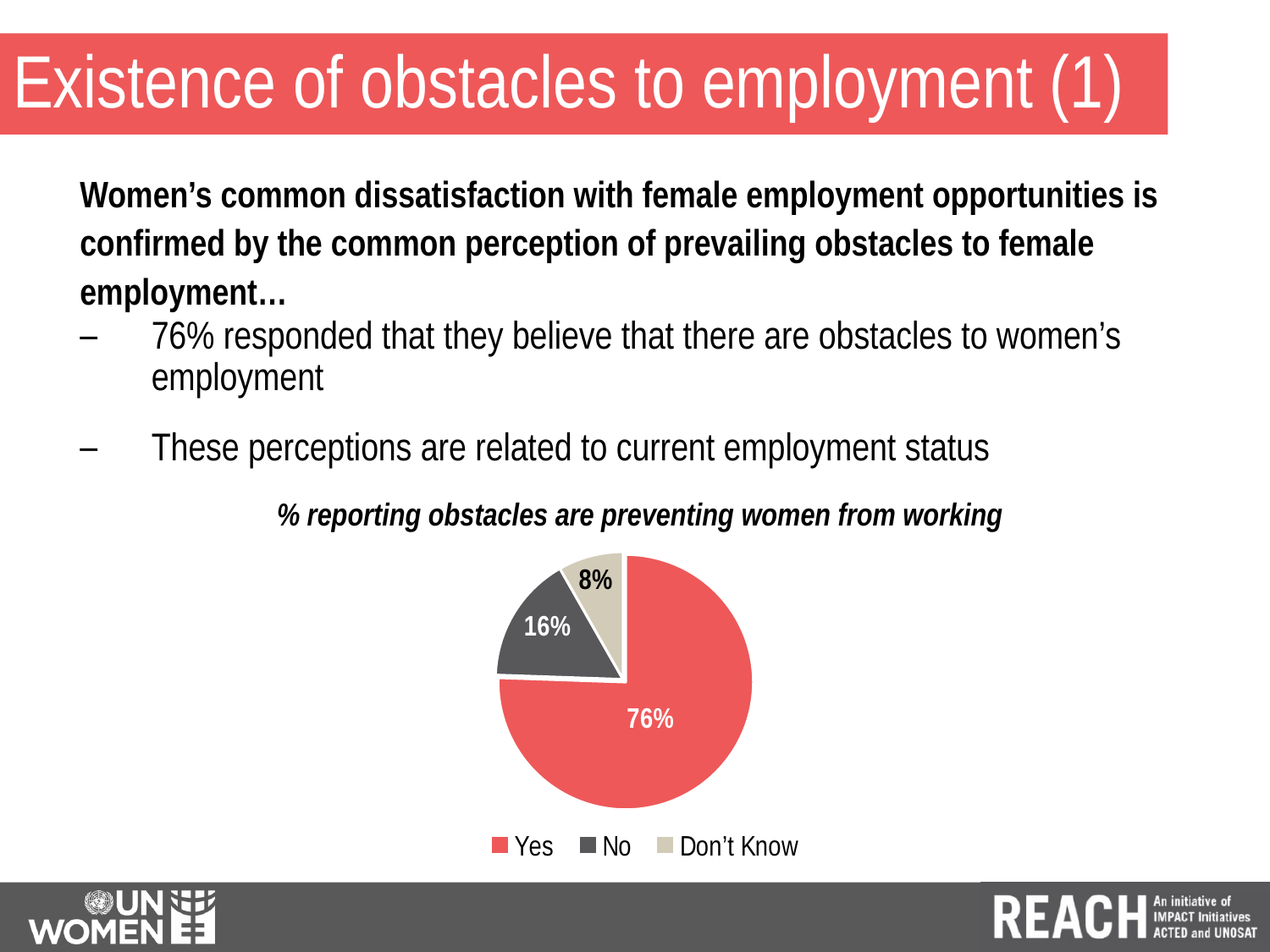
How many slices does the pie chart have? 3 What is the title of the pie chart? % reporting obstacles are preventing women from working What percentage of respondents answered "No"? 16% What percentage of respondents answered "Don't Know"? 8% Which response has the smallest share of the pie? Don't Know What colour is the "Yes" slice in the pie chart? red What percentage of respondents answered "Yes" that obstacles are preventing women from working? 76% What kind of chart is shown on the slide? pie chart Which is larger, the share for "No" or the share for "Don't Know"? No Which response has the largest share of the pie? Yes What is the difference in percentage points between the "No" and "Don't Know" shares? 8 What is the difference in percentage points between the "Yes" and "No" shares? 60